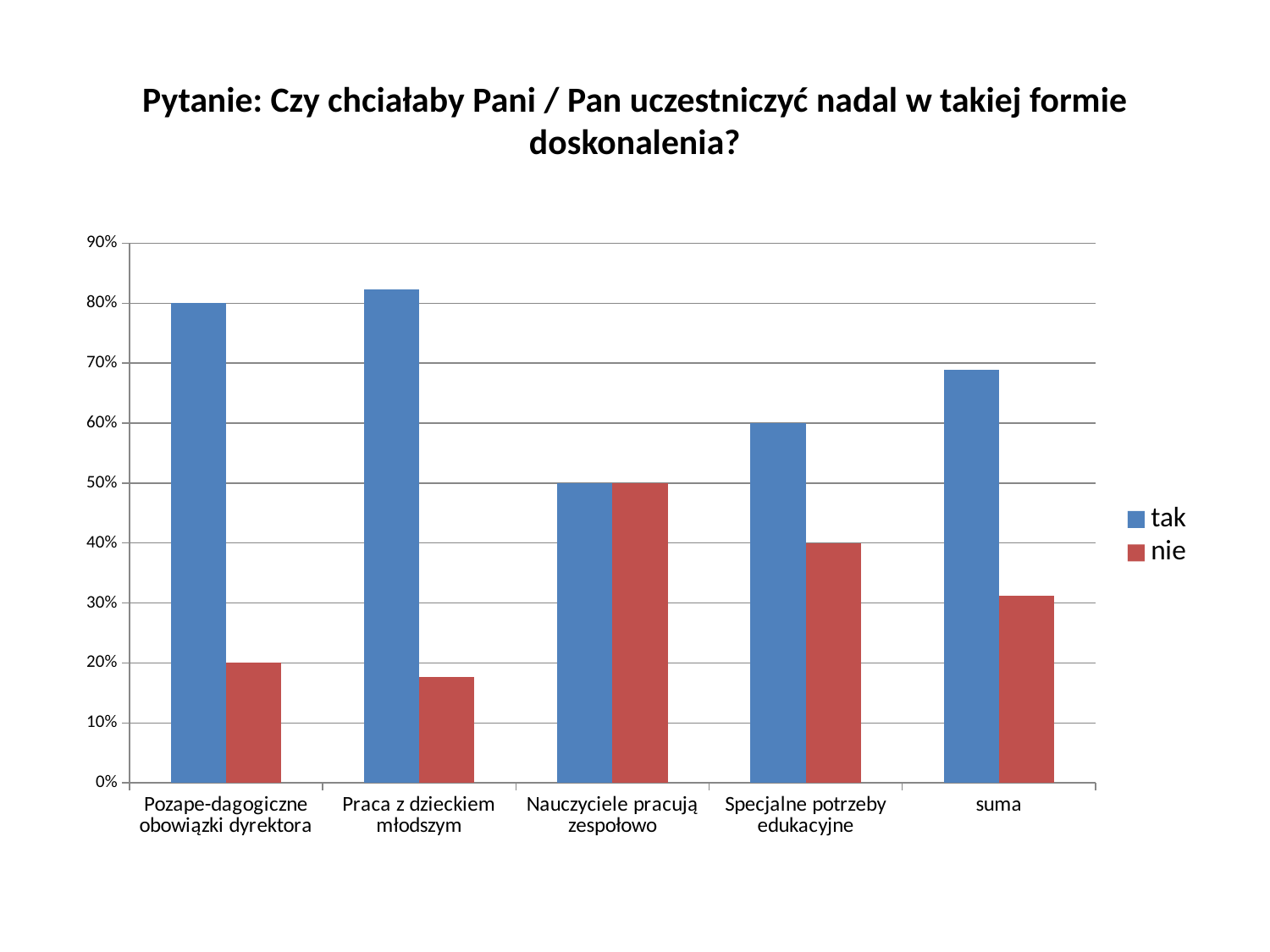
Which is larger for 'suma', 'tak' or 'nie'? tak How many series does the legend list? 2 What type of chart is shown on the slide? bar chart What is the value of 'nie' for 'Specjalne potrzeby edukacyjne'? 40% What is the difference between 'tak' and 'nie' for 'Specjalne potrzeby edukacyjne'? 20% How many categories are shown on the x axis? 5 Which category has the highest 'tak' value? Praca z dzieckiem młodszym What is the value of 'nie' for 'Pozape-dagogiczne obowiązki dyrektora'? 20% Is the 'tak' value for 'suma' greater or less than 60%? greater What is the value of 'tak' for 'Pozape-dagogiczne obowiązki dyrektora'? 80% Which category has the lowest 'nie' value? Praca z dzieckiem młodszym What is the value of 'tak' for 'Nauczyciele pracują zespołowo'? 50%